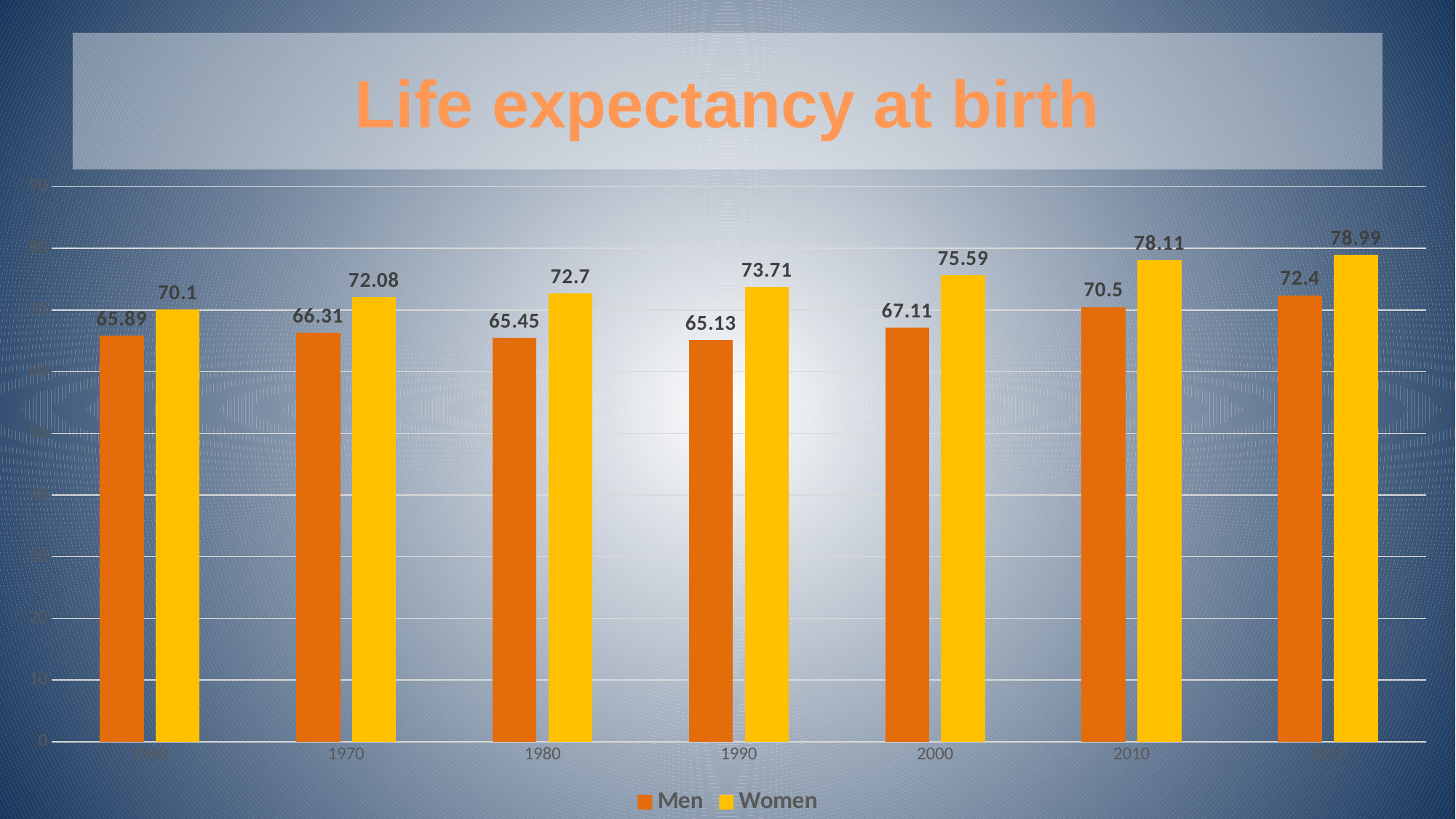
Which year has the larger value for Men, 1970 or 1980? 1970 How much higher is the Women value in 2010 than in 1970? 6.03 What is the difference between the Women and Men values in 2000? 8.48 What is the value for Men in 2010? 70.5 What kind of chart is shown on the slide? Bar chart In which year is the value for Men the lowest? 1990 What is the life expectancy value for Men in 1980? 65.45 What is the life expectancy value for Women in 2000? 75.59 Do the values for Women rise or fall from left to right along the x axis? Rise How many series does the legend list? 2 What is the value for Women in 1990? 73.71 What is the highest value shown for the Women series? 78.99